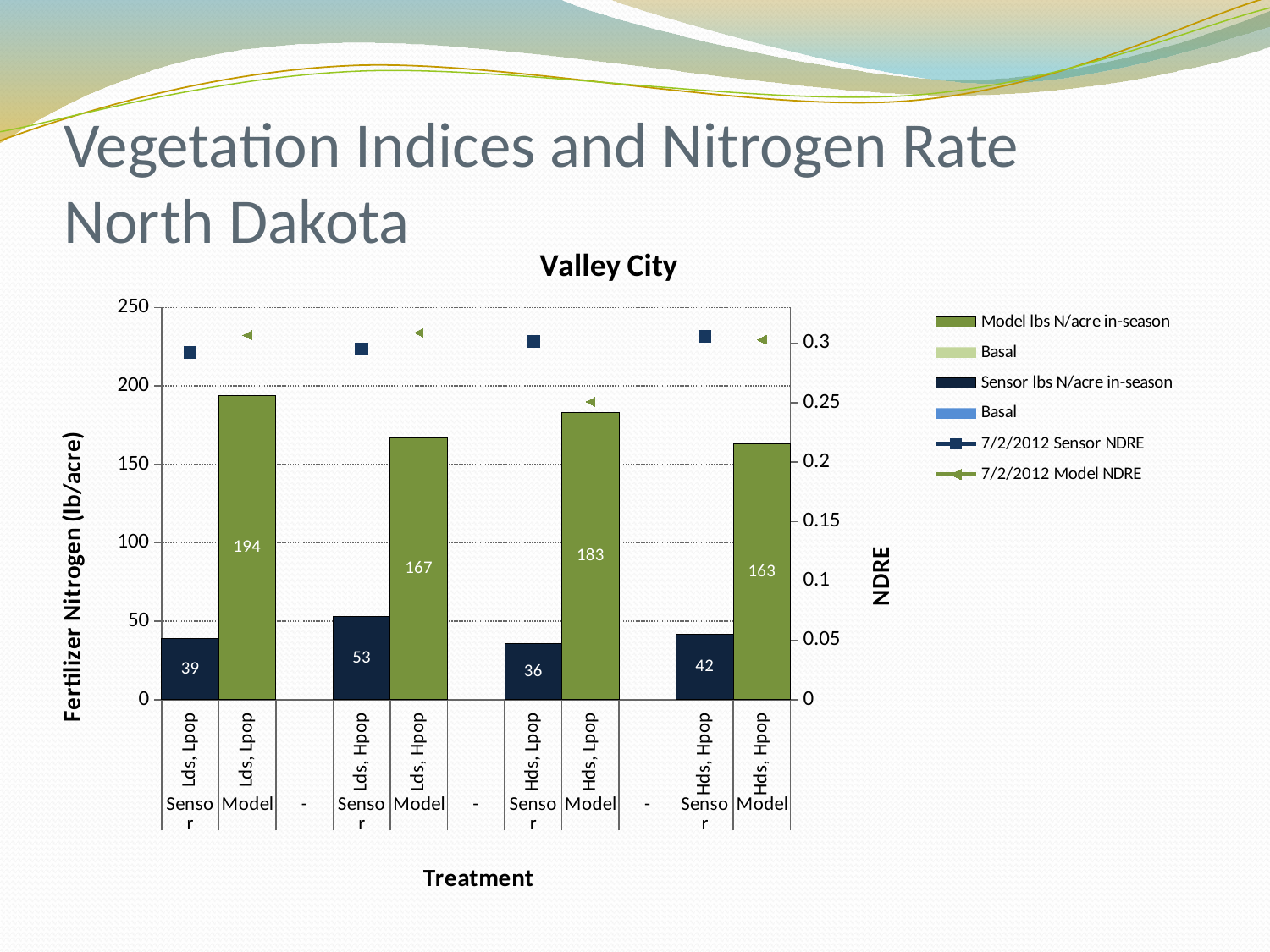
How many entries does the legend list? 6 What is the difference between the Model and Sensor lbs N/acre in-season values for the Hds, Lpop treatment? 147 What is the Model lbs N/acre in-season value for the Hds, Hpop treatment? 163 Which is larger, the Model value for Lds, Hpop or the Model value for Hds, Lpop? Hds, Lpop Which treatment has the lowest Sensor lbs N/acre in-season value? Hds, Lpop Is the Sensor lbs N/acre in-season value for Hds, Hpop greater or less than 50? less What is the Sensor lbs N/acre in-season value for the Hds, Lpop treatment? 36 What is the Model lbs N/acre in-season value for the Lds, Lpop treatment? 194 What is the Sensor lbs N/acre in-season value for the Lds, Hpop treatment? 53 Which treatment has the highest Model lbs N/acre in-season value? Lds, Lpop What is the title of the chart? Valley City What is the label of the right-hand vertical axis? NDRE